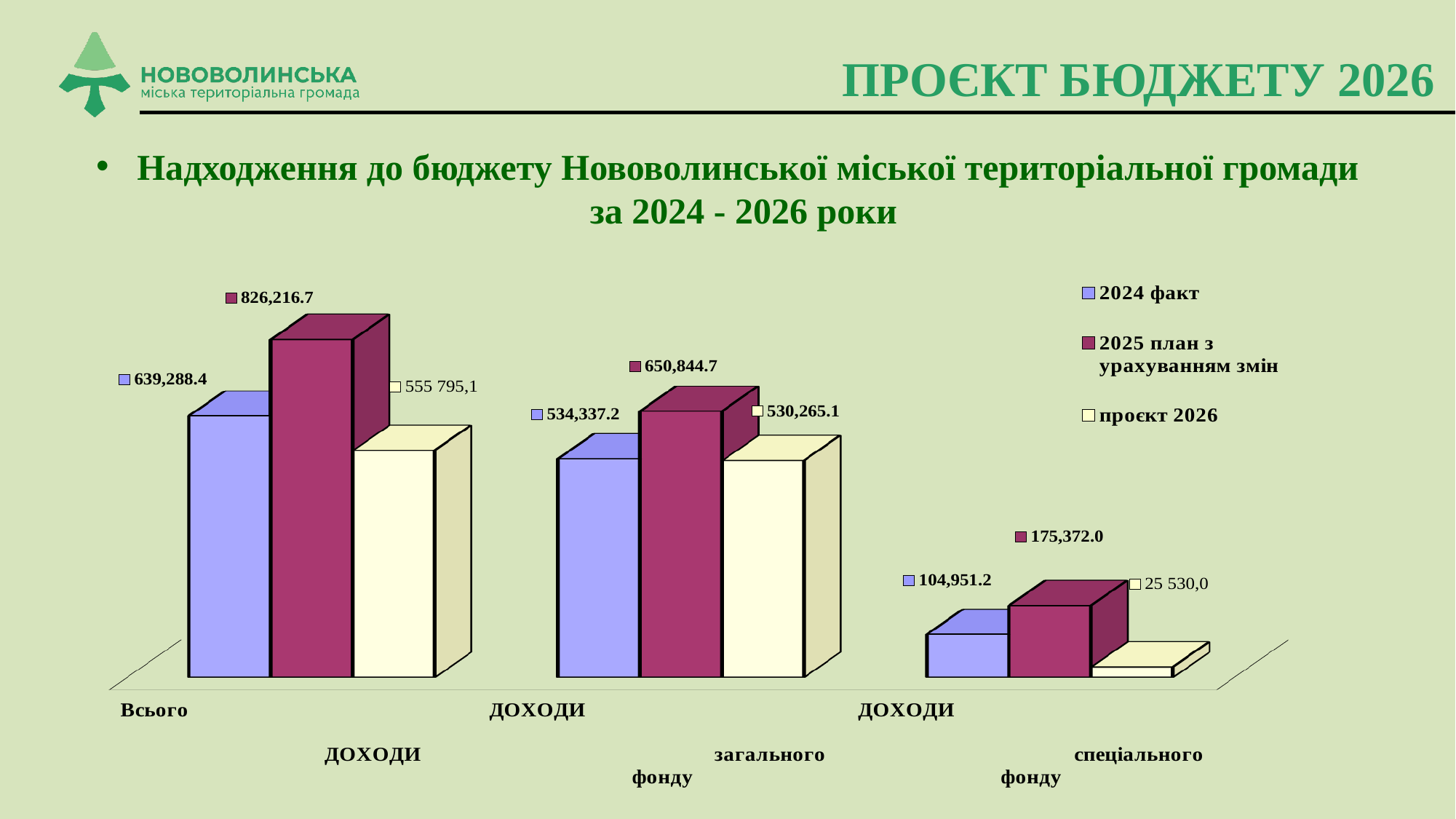
What is the value for "2024 факт" in the "Всього доходи" category? 639,288.4 What is the value for "проєкт 2026" in the "Всього доходи" category? 555 795,1 What kind of chart is shown on the slide? Bar chart What is the difference between the "2025 план з урахуванням змін" and "2024 факт" values in the "Всього доходи" category? 186,928.3 What is the difference between the "2025 план з урахуванням змін" and "2024 факт" values in the "Доходи спеціального фонду" category? 70,420.8 What is the value for "2025 план з урахуванням змін" in the "Доходи загального фонду" category? 650,844.7 What is the value for "проєкт 2026" in the "Доходи спеціального фонду" category? 25 530,0 How many categories are shown on the x axis of the chart? 3 In the "Доходи загального фонду" category, which is larger: the "2024 факт" value or the "проєкт 2026" value? 2024 факт Which series has the lowest value in the "Доходи спеціального фонду" category? проєкт 2026 Which series has the highest value in the "Всього доходи" category? 2025 план з урахуванням змін How many series does the chart legend list? 3